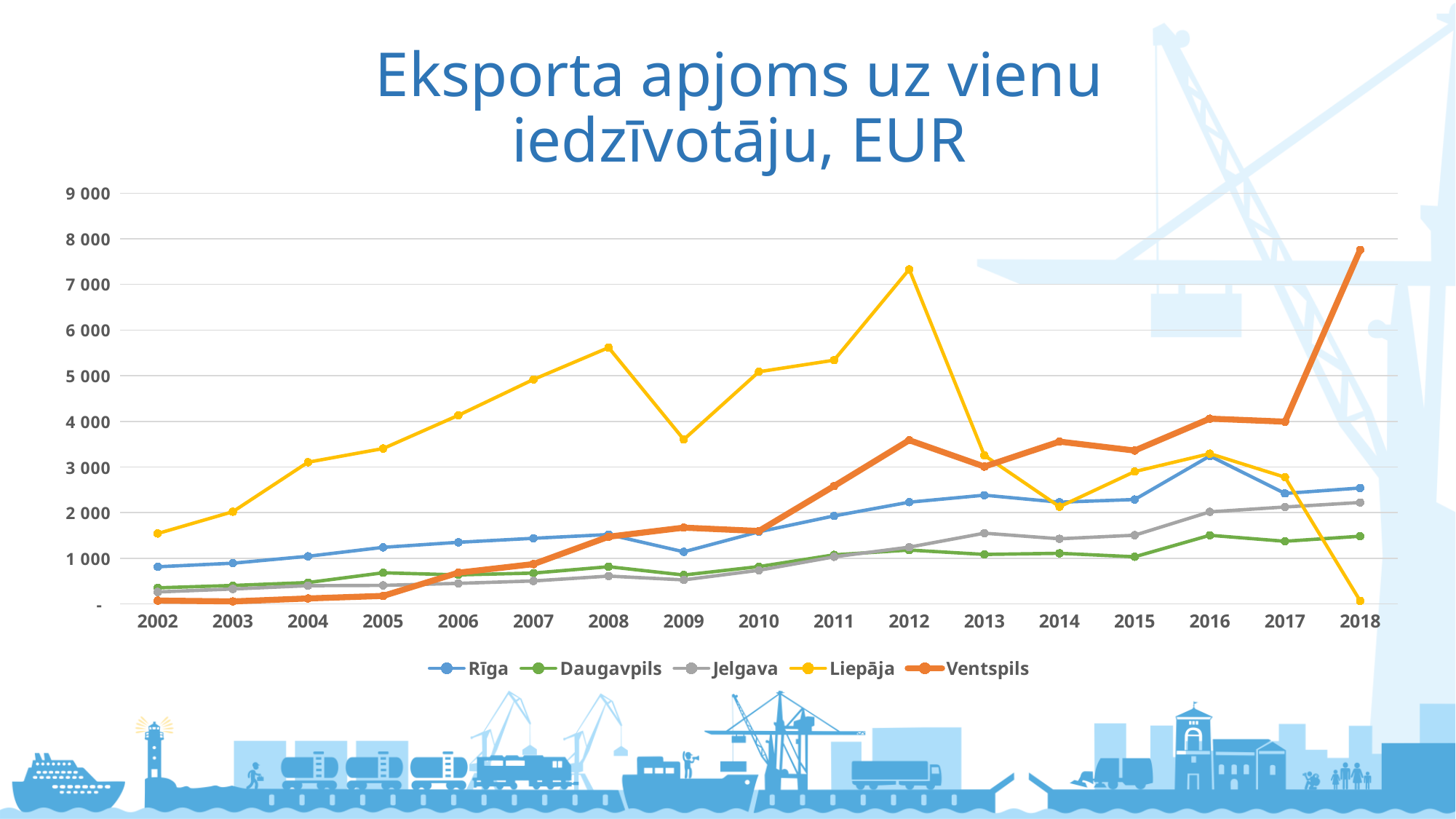
Is the value for Rīga in 2016 greater or less than 2 000? greater In 2008, which is higher, Liepāja or Ventspils? Liepāja How many series does the legend list? 5 How many years are plotted along the x axis? 17 Which city has the lowest value in 2018? Liepāja Which series is drawn with the thick orange line? Ventspils Which city has the highest value in 2002? Liepāja Is the value for Ventspils in 2018 greater or less than 7 000? greater What kind of chart is shown on the slide? line chart In 2014, which is higher, Ventspils or Rīga? Ventspils What is the title of the chart? Eksporta apjoms uz vienu iedzīvotāju, EUR Which city has the highest value in 2018? Ventspils